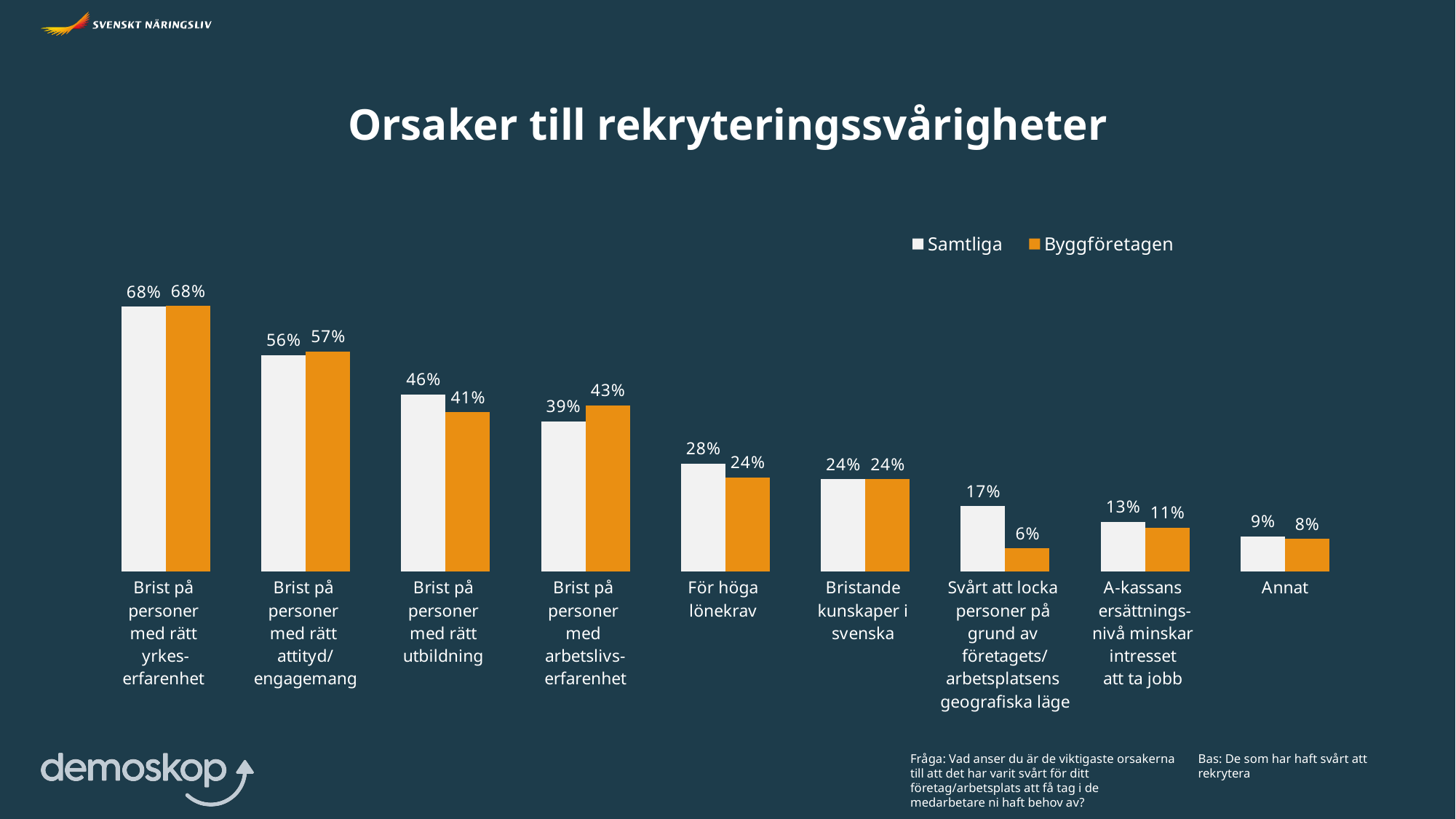
Which category has the lowest Byggföretagen value? Svårt att locka personer på grund av företagets/arbetsplatsens geografiska läge What is the Byggföretagen value for "Brist på personer med rätt utbildning"? 41% What is the Samtliga value for "För höga lönekrav"? 28% Do the Samtliga values rise or fall from left to right along the x axis? Fall What is the title of the chart? Orsaker till rekryteringssvårigheter How many series does the legend list? 2 For "Brist på personer med arbetslivserfarenhet", which series has the larger value, Samtliga or Byggföretagen? Byggföretagen What kind of chart is shown on the slide? Bar chart What is the difference between the Samtliga and Byggföretagen values for "Svårt att locka personer på grund av företagets/arbetsplatsens geografiska läge"? 11 percentage points What is the Byggföretagen value for "Svårt att locka personer på grund av företagets/arbetsplatsens geografiska läge"? 6% Which category has the highest Samtliga value? Brist på personer med rätt yrkeserfarenhet How many categories are shown on the x axis? 9